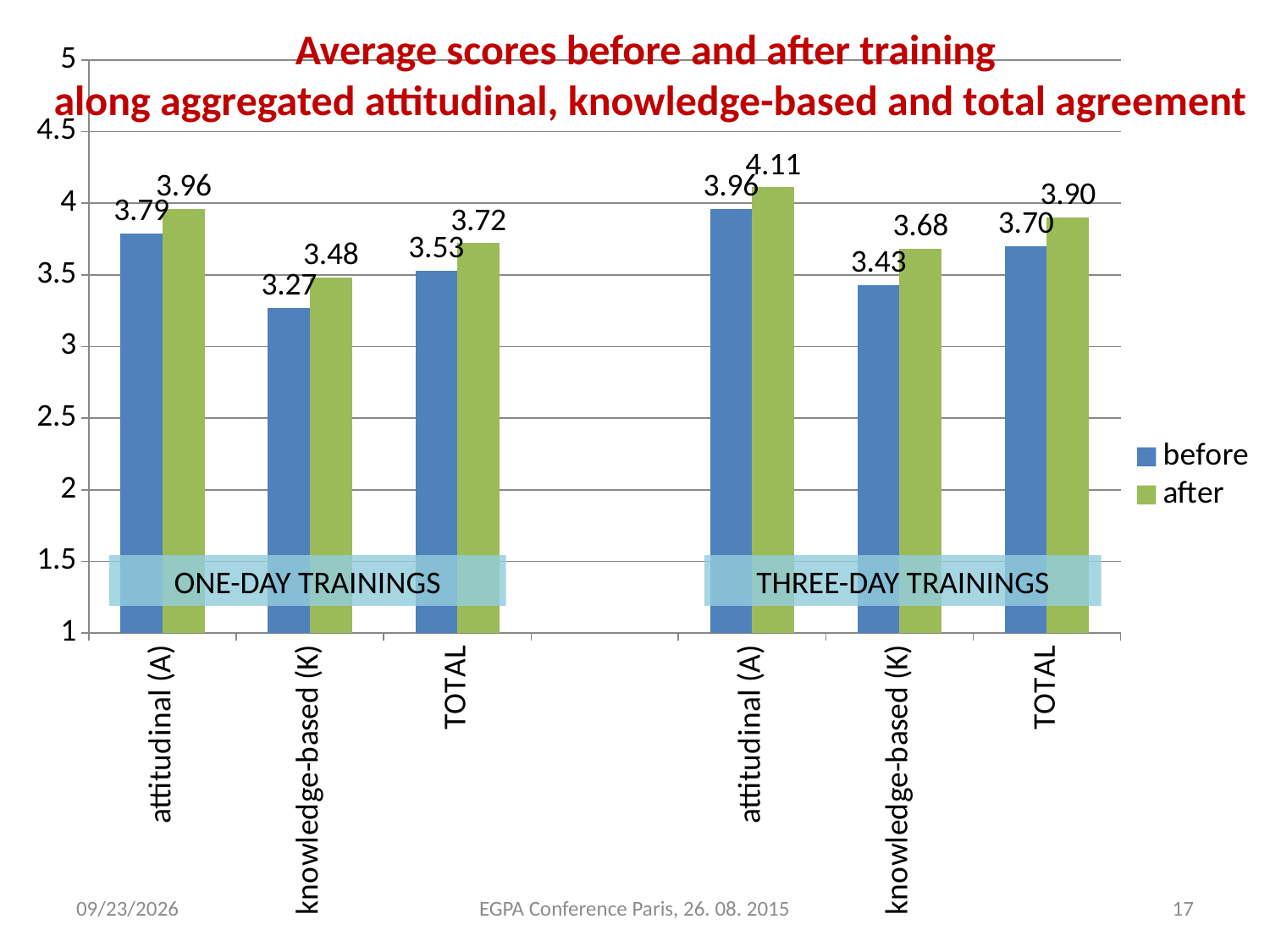
What is the 'after' score for knowledge-based (K) under THREE-DAY TRAININGS? 3.68 What is the difference between the 'after' and 'before' scores for TOTAL under ONE-DAY TRAININGS? 0.19 How many series does the legend list? 2 What colour are the 'after' bars? green Is the 'after' score for attitudinal (A) under THREE-DAY TRAININGS greater or less than 4? greater What is the difference between the 'after' and 'before' scores for knowledge-based (K) under THREE-DAY TRAININGS? 0.25 What is the 'before' score for attitudinal (A) under ONE-DAY TRAININGS? 3.79 Which bar has the lowest value in the chart? before, knowledge-based (K), ONE-DAY TRAININGS (3.27) Which bar has the highest value in the chart? after, attitudinal (A), THREE-DAY TRAININGS (4.11) What kind of chart is shown on the slide? bar chart Which is larger: the 'before' score for attitudinal (A) under THREE-DAY TRAININGS or the 'after' score for attitudinal (A) under ONE-DAY TRAININGS? They are equal (3.96) What is the 'after' score for TOTAL under ONE-DAY TRAININGS? 3.72